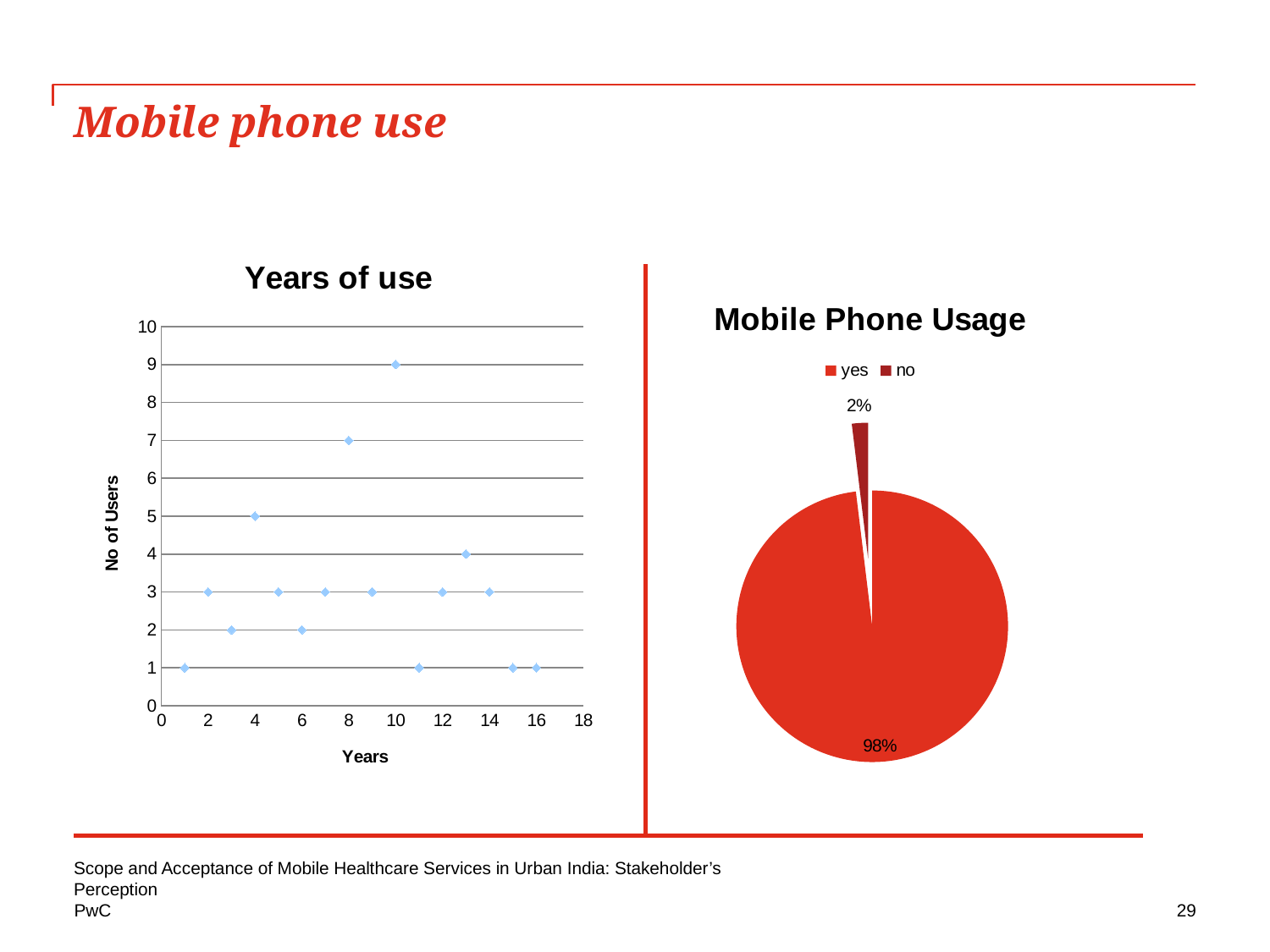
In the Mobile Phone Usage pie chart, which slice is larger, yes or no? yes In the Mobile Phone Usage pie chart, what share of respondents answered no? 2% In the Years of use chart, what is the difference in number of users between 10 years and 8 years? 2 What kind of chart is the Mobile Phone Usage chart? pie chart In the Mobile Phone Usage pie chart, what share of respondents answered yes? 98% How many data points are plotted in the Years of use chart? 16 In the Years of use chart, at how many years of use is the number of users highest? 10 In the Years of use chart, what is the number of users at 10 years? 9 In the Years of use chart, what is the number of users at 8 years? 7 What is the label of the vertical axis in the Years of use chart? No of Users How many entries does the legend of the Mobile Phone Usage chart list? 2 What kind of chart is the Years of use chart? scatter chart